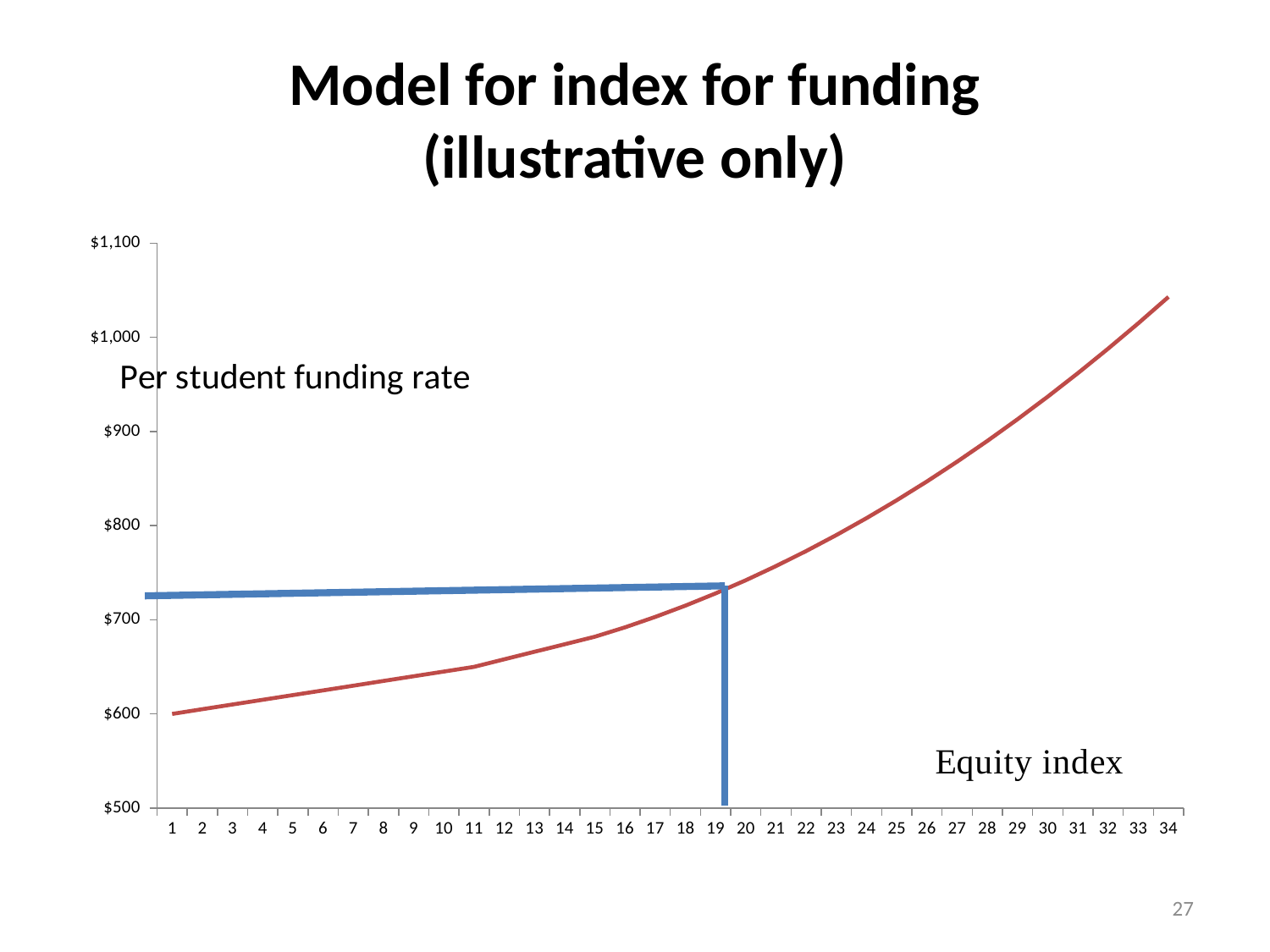
What is the title of the chart? Model for index for funding (illustrative only) What label is shown for the horizontal axis of the chart? Equity index At which equity index is the per student funding rate highest? 34 Is the per student funding rate at equity index 31 greater or less than $900? greater Is the per student funding rate at equity index 34 greater or less than $1,000? greater Is the per student funding rate at equity index 11 greater or less than $700? less What is the per student funding rate at equity index 1? $600 What kind of chart is shown on the slide? line chart At which equity index is the per student funding rate lowest? 1 How many equity index values are shown along the x axis? 34 Does the per student funding rate rise or fall as the equity index increases? rises